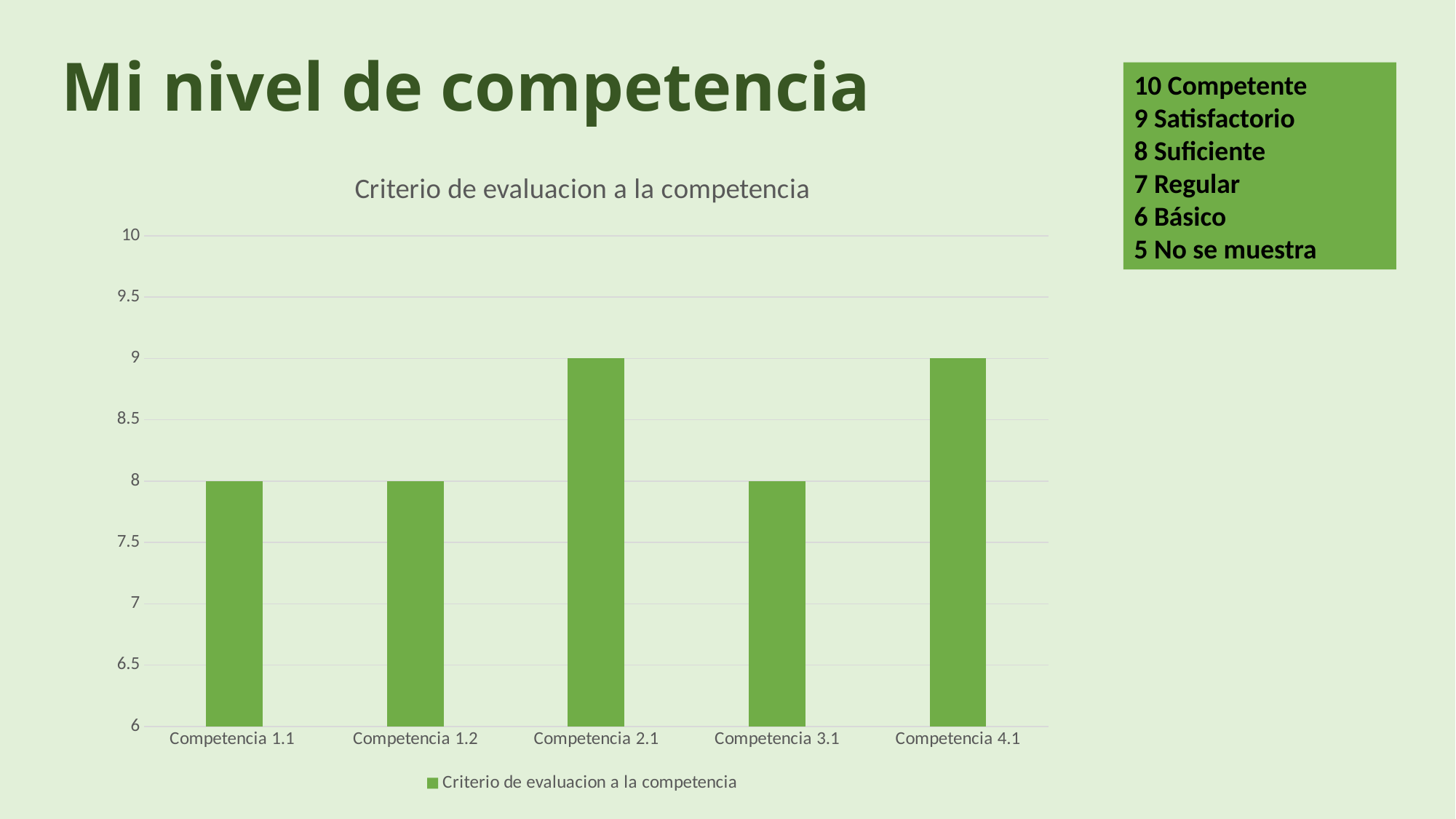
What is the value for Competencia 2.1? 9 What is the value for Competencia 1.1? 8 What is the value for Competencia 3.1? 8 How many categories are shown on the x axis of the chart? 5 What is the value for Competencia 4.1? 9 What is the title of the chart? Criterio de evaluacion a la competencia Is the value for Competencia 1.2 greater or less than 8.5? less What is the difference between the values for Competencia 2.1 and Competencia 3.1? 1 Which is larger, the value for Competencia 2.1 or the value for Competencia 1.2? Competencia 2.1 What kind of chart is shown on the slide? Bar chart Is the value for Competencia 4.1 greater or less than 8.5? greater Which is larger, the value for Competencia 3.1 or the value for Competencia 4.1? Competencia 4.1